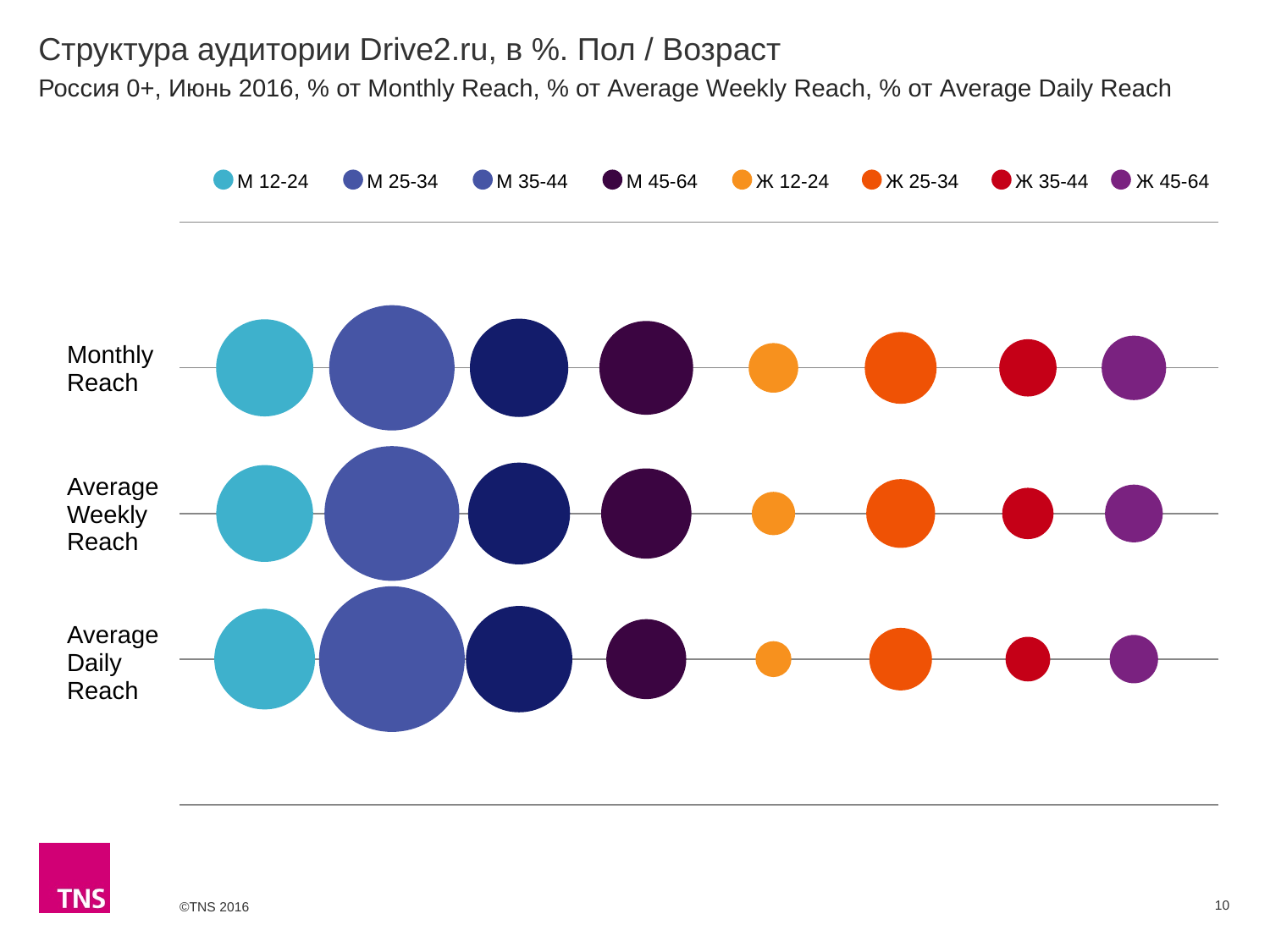
In the Average Daily Reach row, which bubble is larger: М 25-34 or Ж 12-24? М 25-34 Which series has the largest bubble in the Monthly Reach row? М 25-34 In the Monthly Reach row, which bubble is larger: М 12-24 or Ж 45-64? М 12-24 In the Average Weekly Reach row, which bubble is larger: Ж 25-34 or Ж 12-24? Ж 25-34 Which series has the smallest bubble in the Average Daily Reach row? Ж 12-24 How many reach categories (rows) are plotted on the chart? 3 How many series does the legend list? 8 Which series has the largest bubble in the Average Weekly Reach row? М 25-34 Which series has the smallest bubble in the Monthly Reach row? Ж 12-24 What kind of chart is shown on the slide? Bubble chart What is the label of the bottom row of the chart? Average Daily Reach What is the first series listed in the legend? М 12-24